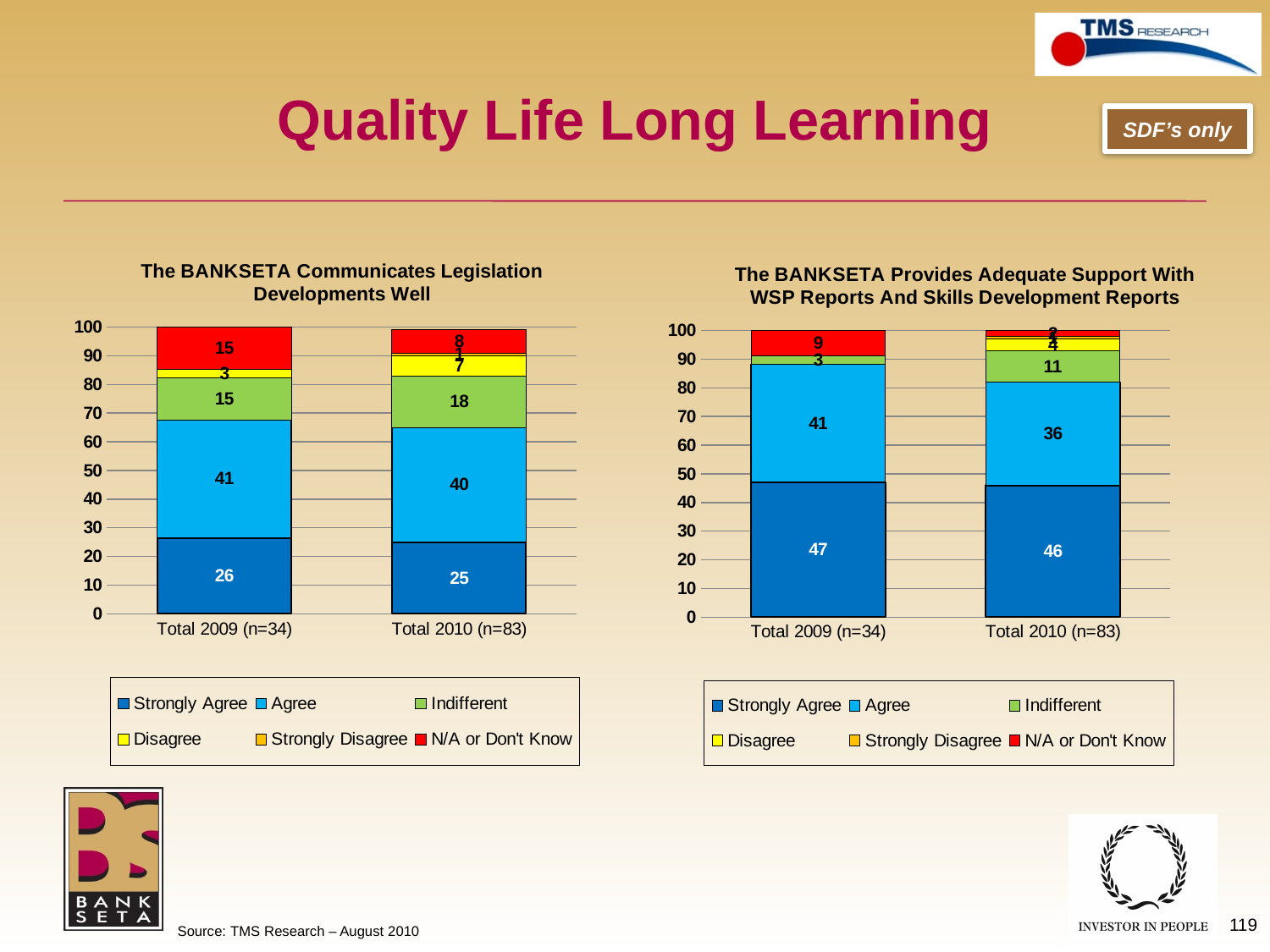
In the chart titled 'The BANKSETA Provides Adequate Support With WSP Reports And Skills Development Reports', what is the Strongly Agree value for Total 2009 (n=34)? 47 In the chart titled 'The BANKSETA Provides Adequate Support With WSP Reports And Skills Development Reports', what is the Agree value for Total 2010 (n=83)? 36 In the chart titled 'The BANKSETA Communicates Legislation Developments Well', what is the N/A or Don't Know value for Total 2009 (n=34)? 15 In the chart titled 'The BANKSETA Provides Adequate Support With WSP Reports And Skills Development Reports', what is the Indifferent value for Total 2010 (n=83)? 11 In the chart titled 'The BANKSETA Communicates Legislation Developments Well', what is the Indifferent value for Total 2010 (n=83)? 18 In the chart titled 'The BANKSETA Provides Adequate Support With WSP Reports And Skills Development Reports', what is the difference between the Agree values for Total 2009 (n=34) and Total 2010 (n=83)? 5 In the chart titled 'The BANKSETA Communicates Legislation Developments Well', which is larger: the Indifferent value for Total 2009 (n=34) or for Total 2010 (n=83)? Total 2010 (n=83) How many categories are shown on the x axis of the chart titled 'The BANKSETA Communicates Legislation Developments Well'? 2 In the chart titled 'The BANKSETA Communicates Legislation Developments Well', what is the Agree value for Total 2010 (n=83)? 40 How many series does the legend of the chart titled 'The BANKSETA Provides Adequate Support With WSP Reports And Skills Development Reports' list? 6 What kind of chart is the chart on the right of the slide? Stacked bar chart In the chart titled 'The BANKSETA Communicates Legislation Developments Well', what is the Strongly Agree value for Total 2009 (n=34)? 26